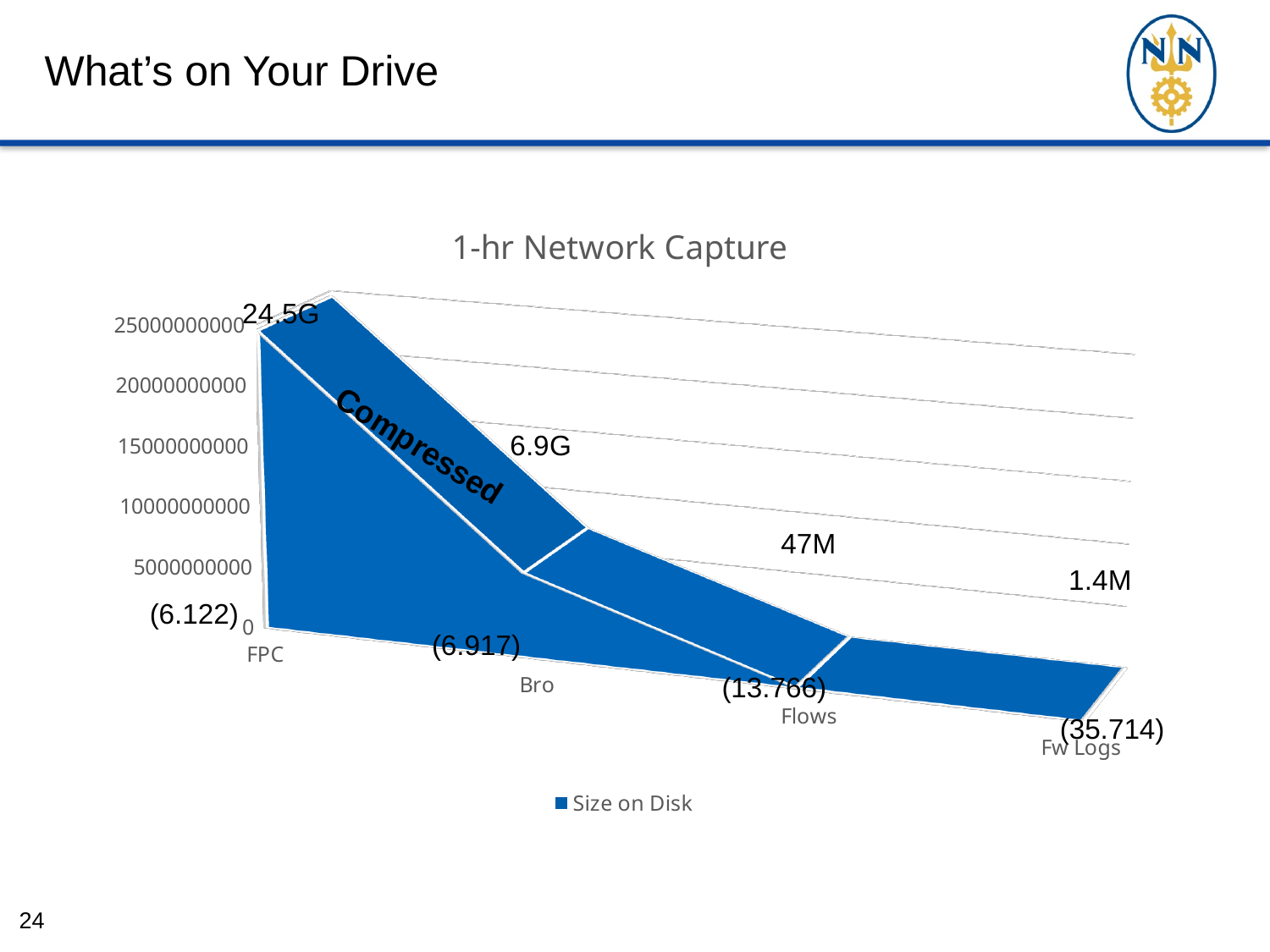
What size label is shown for Flows? 47M What size label is shown for FPC? 24.5G Which category has the largest size on disk? FPC What series name is shown in the chart legend? Size on Disk What size label is shown for Fw Logs? 1.4M What is the title of the chart? 1-hr Network Capture Which category has the smallest size on disk? Fw Logs How many series does the chart legend list? 1 What kind of chart is shown on the slide? area chart Is the value for FPC greater or less than 20000000000? greater What size label is shown for Bro? 6.9G How many categories are shown on the x axis of the chart? 4